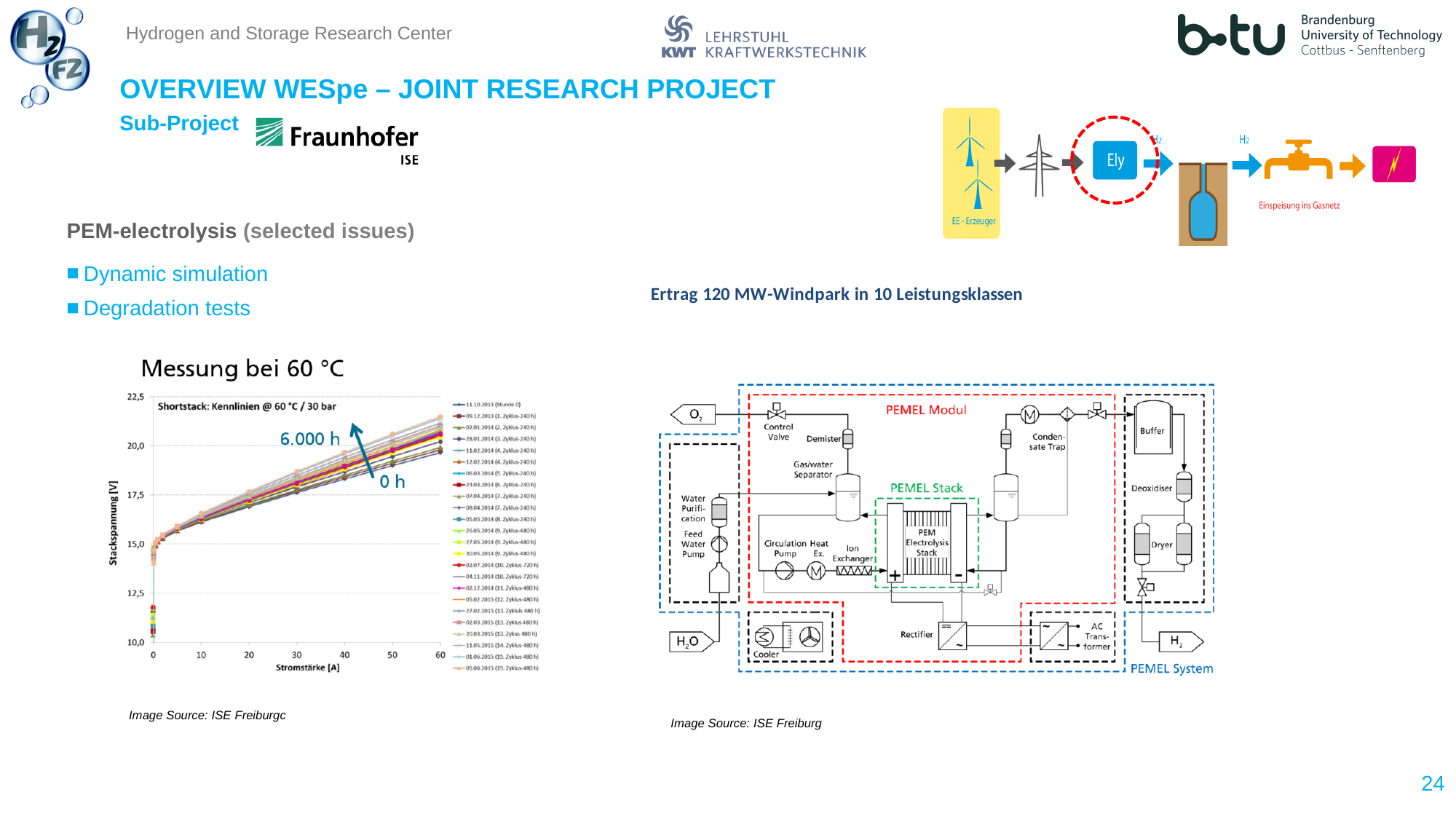
In the "Messung bei 60 °C" chart, is the stack voltage at 60 A greater or less than 22.5 V? less In the "Messung bei 60 °C" chart, is the stack voltage at 20 A greater or less than 15.0 V? greater In the "Messung bei 60 °C" chart, is the stack voltage at 40 A greater or less than 20.0 V? less Which two operating-hour annotations are written next to the arrow in the "Messung bei 60 °C" chart? 6.000 h and 0 h What is the title of the line chart on the left of the slide? Messung bei 60 °C What kind of chart is the "Messung bei 60 °C" chart on the left of the slide? line chart In the "Messung bei 60 °C" chart, do the stack voltage curves rise or fall as the current (Stromstärke) increases from 0 to 60 A? rise